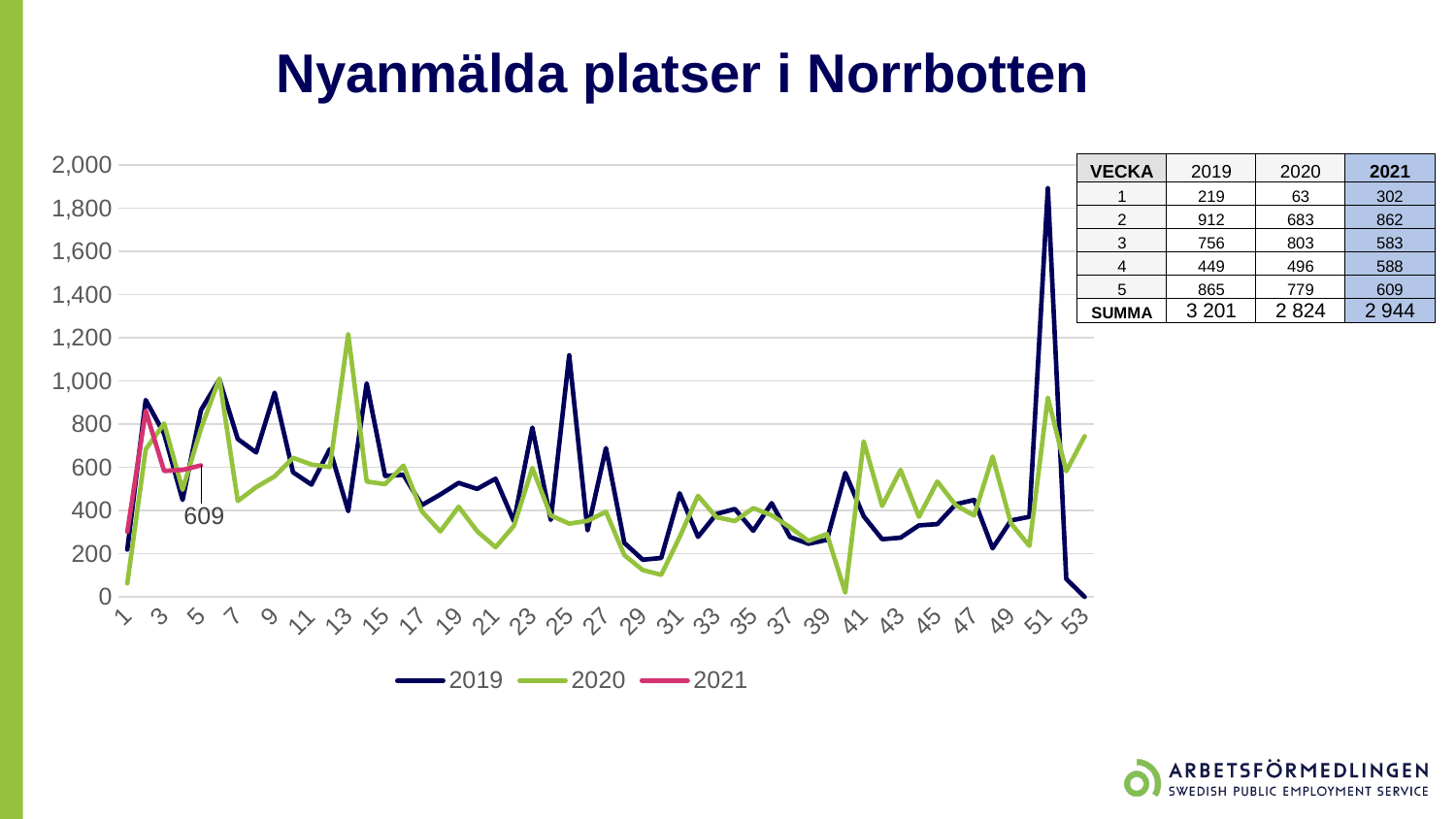
According to the table, what is the 2020 value for week 3? 803 For week 1, which is larger: the 2021 value or the 2020 value? 2021 How many series does the chart legend list? 3 What is the SUMMA (total) for 2021 in the table? 2 944 What value is labelled on the 2021 line at week 5? 609 What kind of chart is shown on the slide? line chart Is the 2020 value at week 13 greater or less than 1,000? greater According to the table, what is the 2019 value for week 1? 219 Which series reaches the highest peak on the chart? 2019 What is the title of the chart? Nyanmälda platser i Norrbotten What is the difference between the 2021 and 2020 values for week 2? 179 Is the peak value of the 2019 line around week 51 greater or less than 1,800? greater